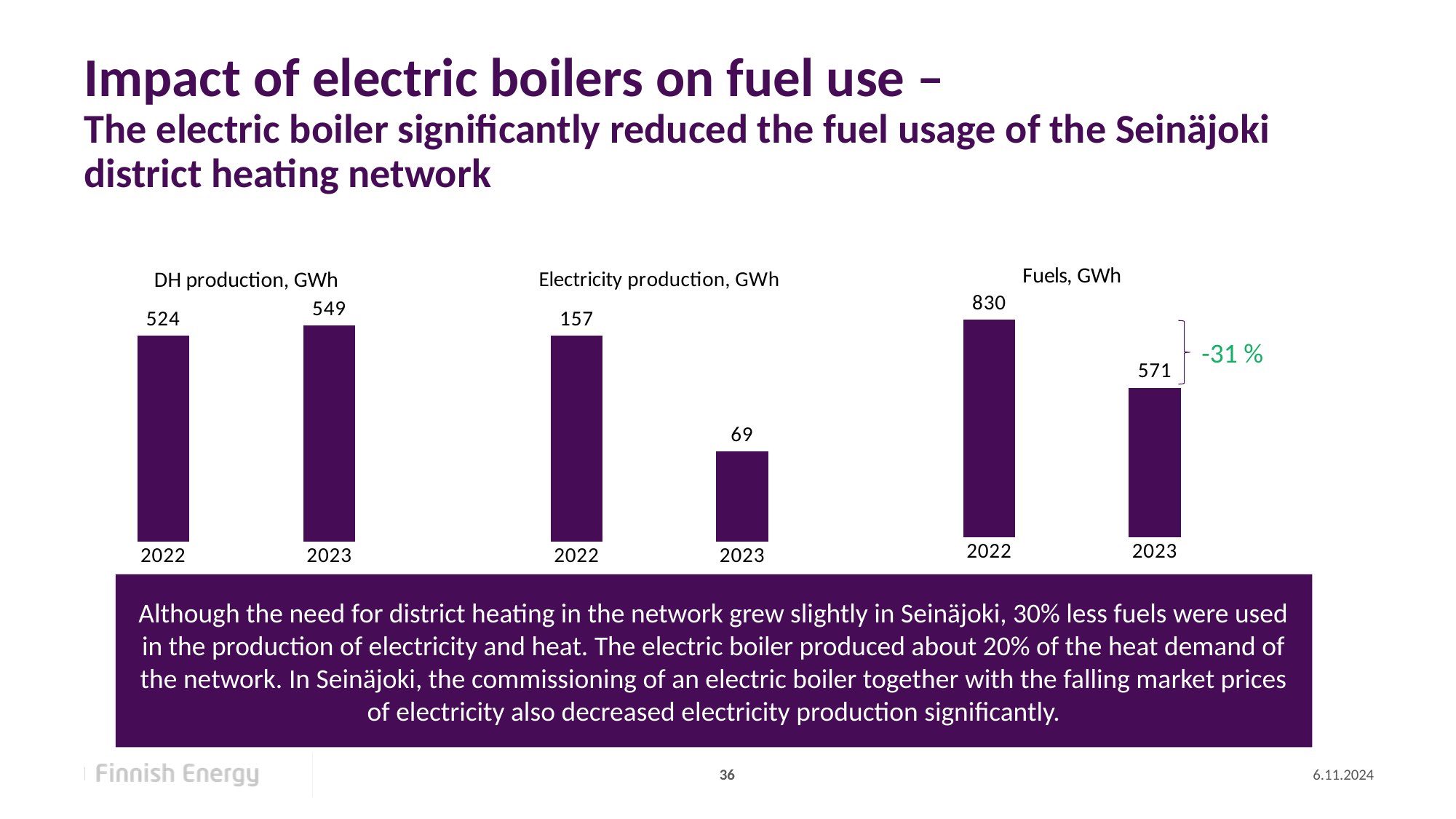
In the 'DH production, GWh' chart, what is the value for 2023? 549 In the 'Fuels, GWh' chart, do the values rise or fall from 2022 to 2023? fall How many bars are shown in the 'Fuels, GWh' chart? 2 In the 'Electricity production, GWh' chart, which year has the lowest value? 2023 What kind of chart is the 'Electricity production, GWh' chart? bar chart In the 'Fuels, GWh' chart, what is the value for 2022? 830 In the 'DH production, GWh' chart, which year has the higher value, 2022 or 2023? 2023 In the 'DH production, GWh' chart, what is the value for 2022? 524 In the 'Fuels, GWh' chart, what is the difference between the 2022 and 2023 values? 259 What percentage change is annotated next to the 'Fuels, GWh' chart? -31 % In the 'Electricity production, GWh' chart, what is the value for 2023? 69 In the 'Electricity production, GWh' chart, what is the difference between the 2022 and 2023 values? 88